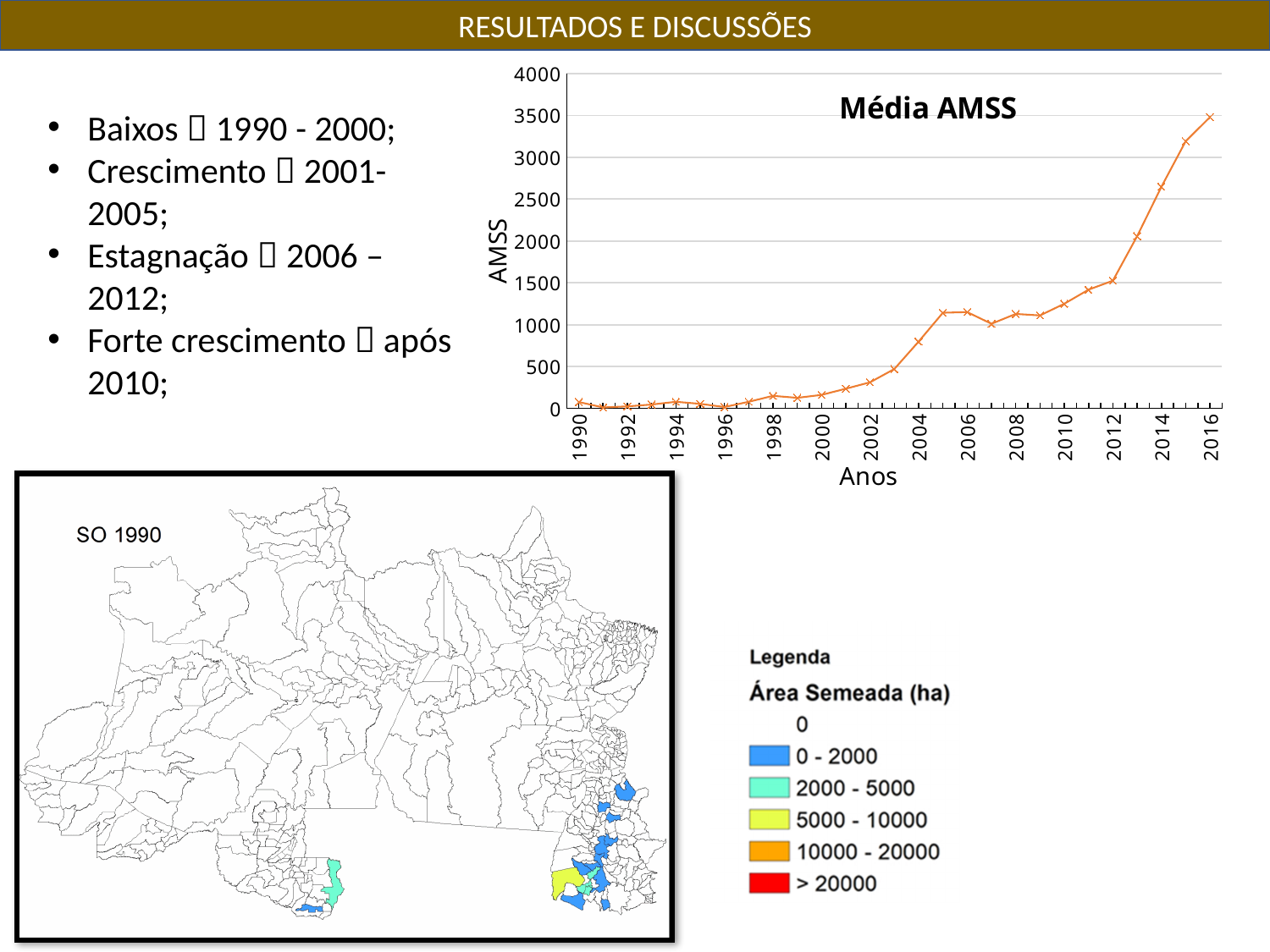
In the "Média AMSS" chart, is the value for 2016 greater or less than 3000? greater In the "Média AMSS" chart, do the values generally rise or fall from 1990 to 2016? rise In the "Média AMSS" chart, is the value for 2010 greater or less than 1500? less What is the label of the x axis of the "Média AMSS" chart? Anos How many yearly data points are plotted in the "Média AMSS" chart? 27 What type of chart is the "Média AMSS" chart? line chart In the "Média AMSS" chart, which year has the highest value? 2016 In the "Média AMSS" chart, is the value for 2000 greater or less than 500? less What is the title of the chart on the slide? Média AMSS In the "Média AMSS" chart, which year has the larger value, 2005 or 2000? 2005